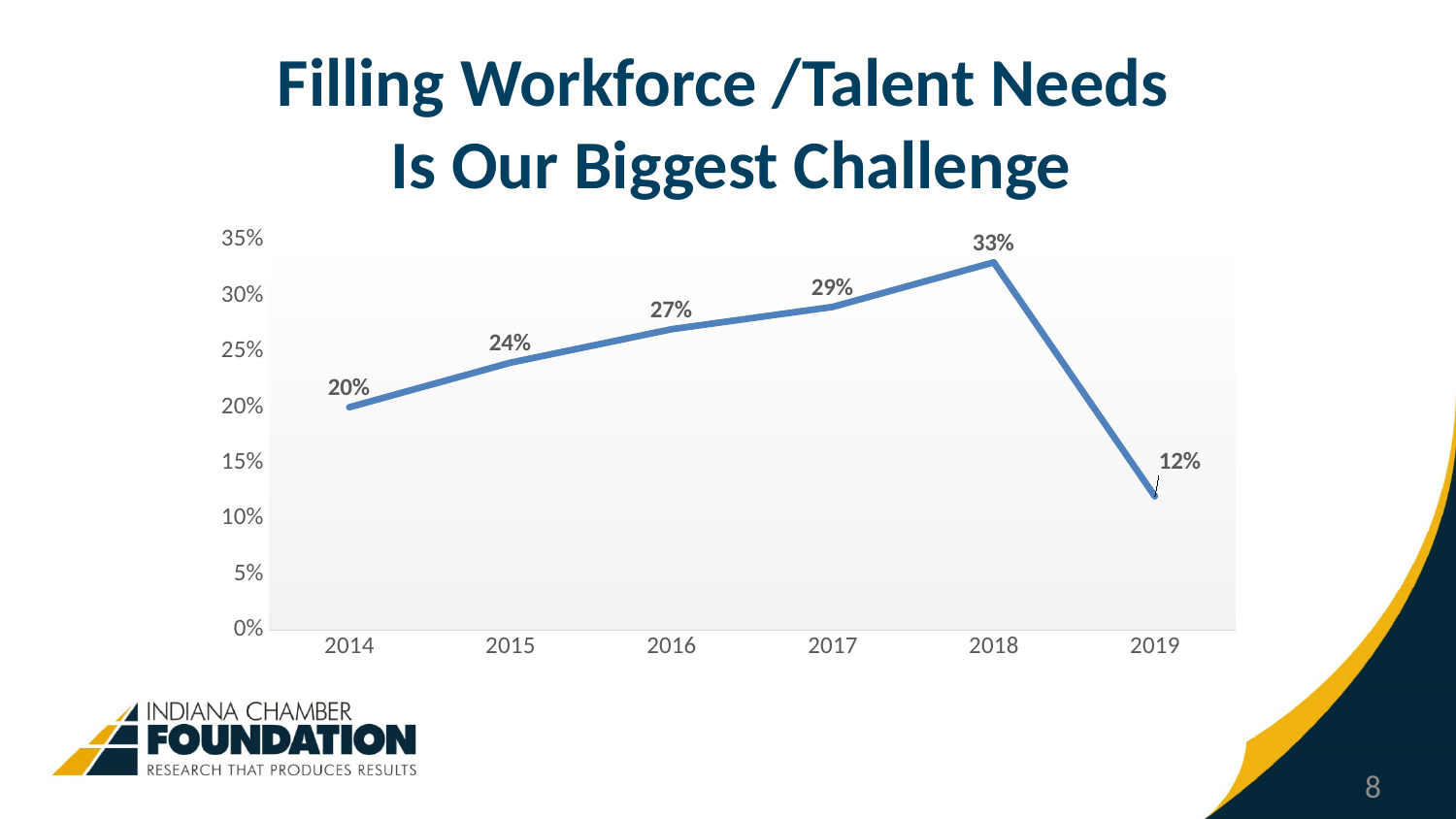
Which is larger, the value for 2016 or the value for 2014? 2016 How many years are plotted on the chart? 6 Which year has the lowest value? 2019 Do the values rise or fall from 2014 to 2018? rise What is the value for 2019? 12% What is the difference between the values for 2018 and 2019? 21% Which year has the highest value? 2018 What is the value for 2017? 29% Is the value for 2018 greater or less than 30%? greater What kind of chart is shown on the slide? line chart What is the value for 2014? 20% What is the difference between the values for 2016 and 2015? 3%